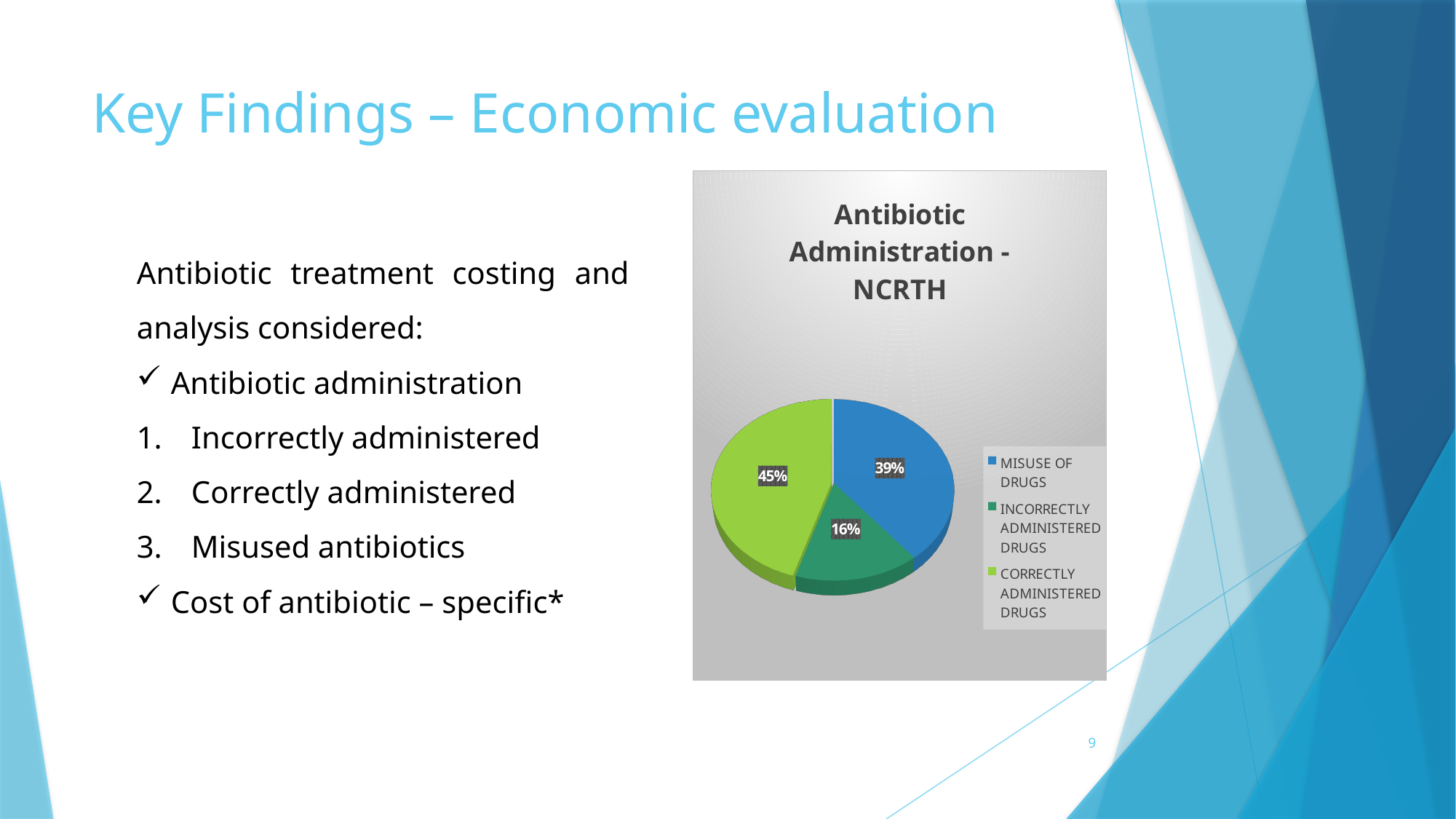
Which is larger, the share for Misuse of Drugs or the share for Incorrectly Administered Drugs? Misuse of Drugs What percentage of the pie is Misuse of Drugs? 39% What is the combined percentage of Misuse of Drugs and Incorrectly Administered Drugs? 55% Which category has the smallest share of the pie? Incorrectly Administered Drugs How many slices does the pie chart have? 3 Which category has the largest share of the pie? Correctly Administered Drugs What percentage of the pie is Incorrectly Administered Drugs? 16% What is the title of the chart? Antibiotic Administration - NCRTH What is the difference in percentage points between Correctly Administered Drugs and Misuse of Drugs? 6 What colour is the slice for Misuse of Drugs? Blue What type of chart is shown on the slide? Pie chart What percentage of the pie is Correctly Administered Drugs? 45%